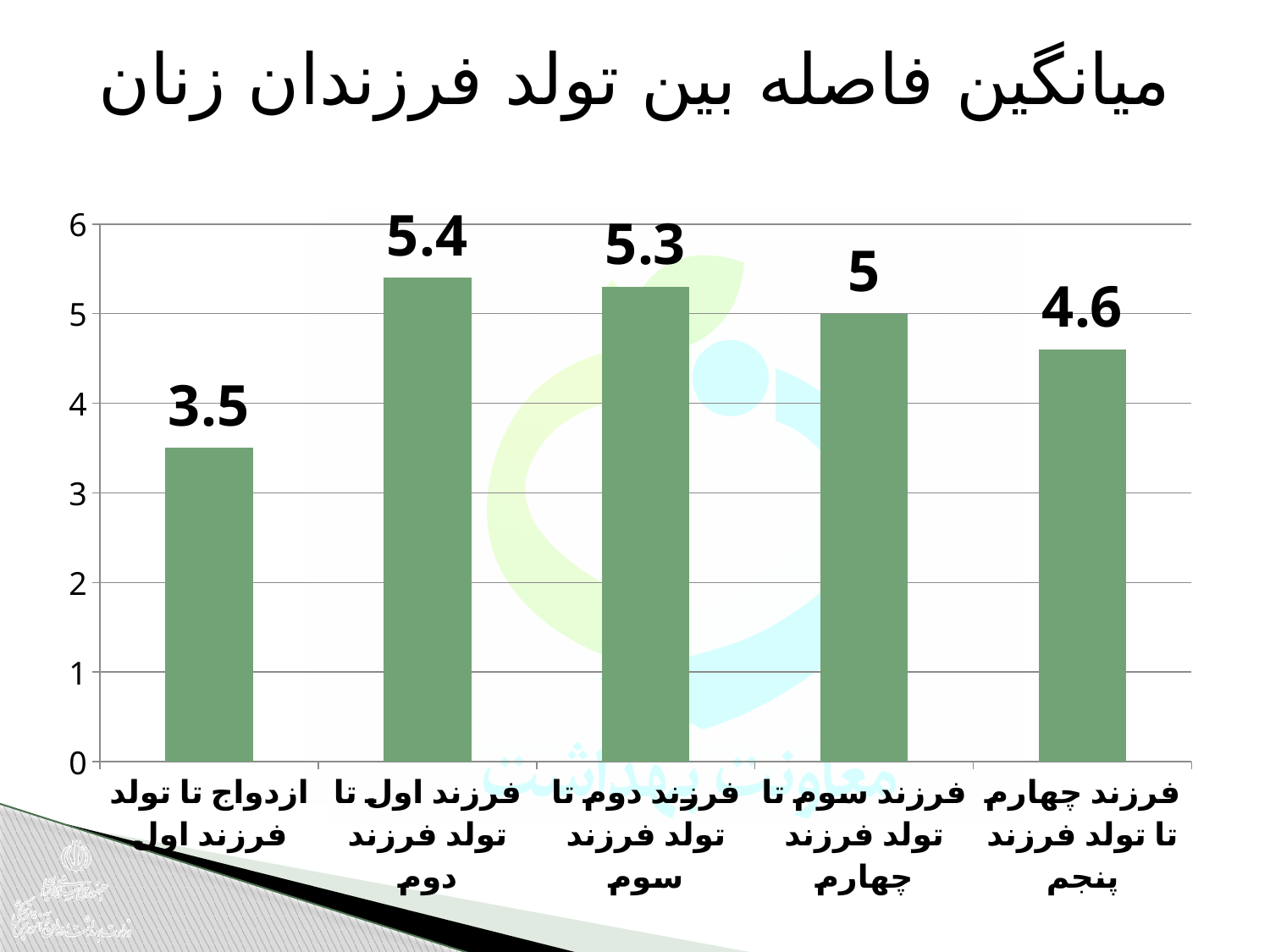
What is the value for the category "فرزند اول تا تولد فرزند دوم" (first child to birth of second child)? 5.4 What is the difference between the values for "فرزند سوم تا تولد فرزند چهارم" and "فرزند چهارم تا تولد فرزند پنجم"? 0.4 What is the value for the category "فرزند چهارم تا تولد فرزند پنجم" (fourth child to birth of fifth child)? 4.6 Which category has the lowest value? ازدواج تا تولد فرزند اول What is the value for the category "ازدواج تا تولد فرزند اول" (marriage to birth of first child)? 3.5 Is the value for "ازدواج تا تولد فرزند اول" greater or less than 4? less Which is larger: the value for "فرزند دوم تا تولد فرزند سوم" or the value for "فرزند چهارم تا تولد فرزند پنجم"? فرزند دوم تا تولد فرزند سوم Which category has the highest value? فرزند اول تا تولد فرزند دوم What kind of chart is shown on the slide? bar chart What is the difference between the values for "فرزند اول تا تولد فرزند دوم" and "ازدواج تا تولد فرزند اول"? 1.9 What is the title of the slide? میانگین فاصله بین تولد فرزندان زنان How many categories are shown on the chart? 5